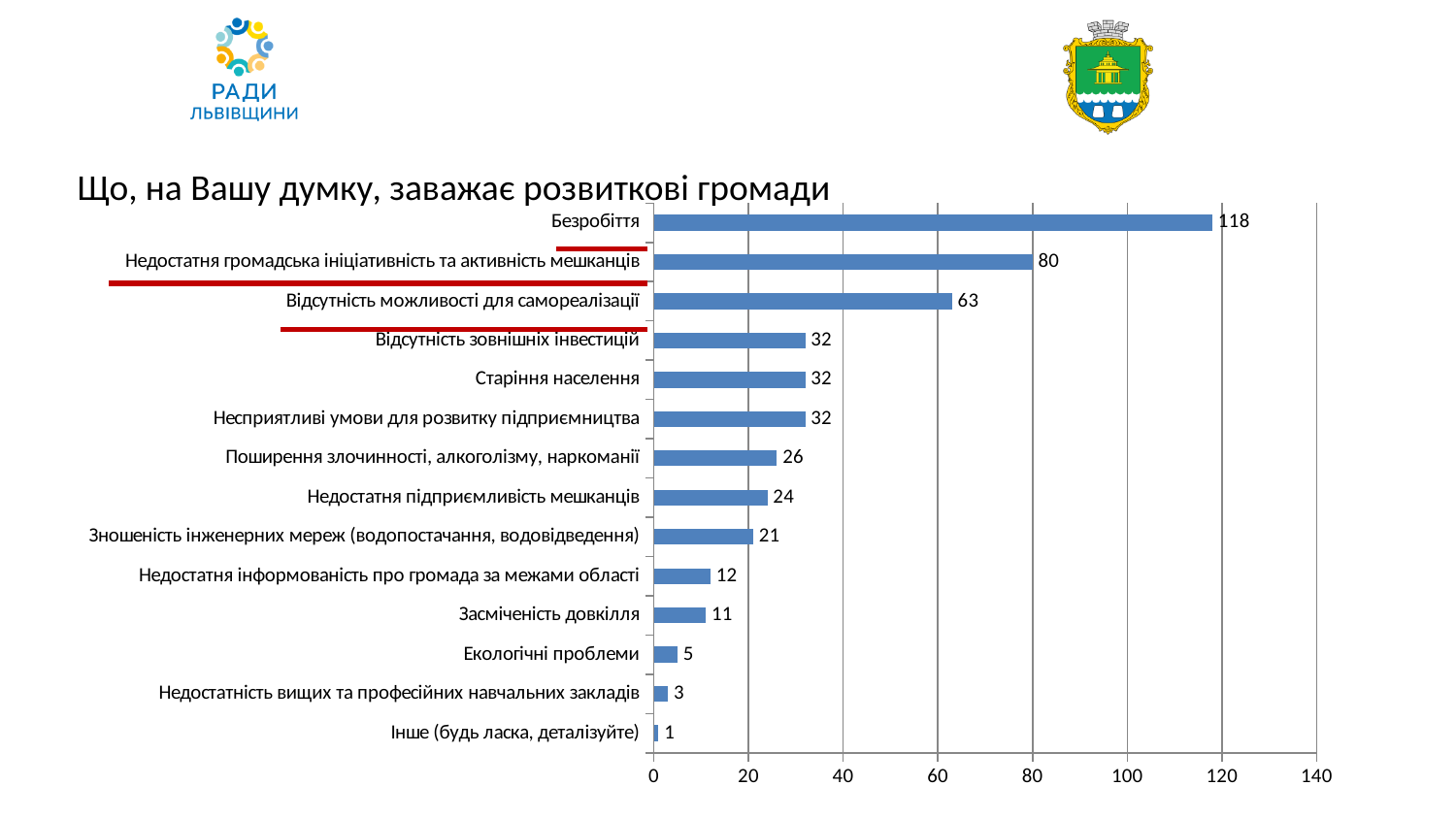
Which is larger: the value for "Поширення злочинності, алкоголізму, наркоманії" or the value for "Недостатня підприємливість мешканців"? Поширення злочинності, алкоголізму, наркоманії What is the value for "Засміченість довкілля"? 11 What kind of chart is shown on the slide? bar chart How many categories are shown in the chart? 14 Which category has the highest value? Безробіття What is the value for "Екологічні проблеми"? 5 What is the title of the chart? Що, на Вашу думку, заважає розвиткові громади What is the value for "Відсутність можливості для самореалізації"? 63 Is the value for "Недостатня громадська ініціативність та активність мешканців" greater or less than 100? less What is the value for "Безробіття"? 118 Which category has the lowest value? Інше (будь ласка, деталізуйте) What is the difference between the values for "Безробіття" and "Недостатня громадська ініціативність та активність мешканців"? 38